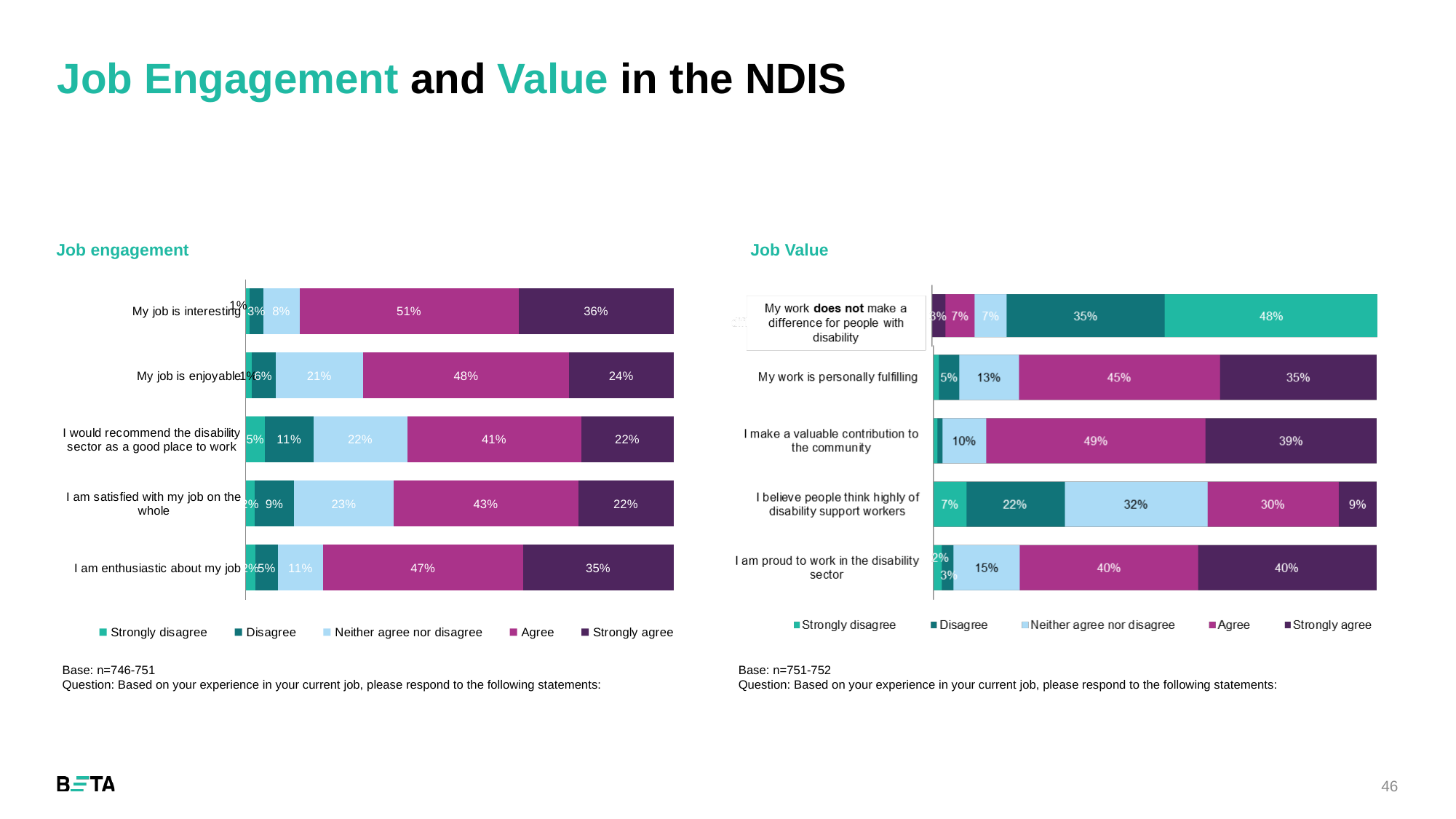
How many statements are shown in the Job engagement chart? 5 In the Job engagement chart, what percentage strongly agree with 'I am enthusiastic about my job'? 35% In the Job Value chart, what percentage neither agree nor disagree with 'I believe people think highly of disability support workers'? 32% What type of chart is the Job engagement chart? Stacked bar chart How many series does the legend of the Job Value chart list? 5 In the Job Value chart, what percentage strongly agree with 'I am proud to work in the disability sector'? 40% In the Job engagement chart, what percentage neither agree nor disagree with 'I am satisfied with my job on the whole'? 23% In the Job Value chart, which is larger: the 'Strongly agree' percentage for 'My work is personally fulfilling' or for 'I believe people think highly of disability support workers'? My work is personally fulfilling In the Job engagement chart, which statement has the highest 'Strongly agree' percentage? My job is interesting In the Job engagement chart, what is the difference between the 'Agree' percentages for 'My job is interesting' and 'I would recommend the disability sector as a good place to work'? 10% In the Job engagement chart, what percentage of respondents agree that 'My job is interesting'? 51% In the Job Value chart, what percentage agree with 'I make a valuable contribution to the community'? 49%